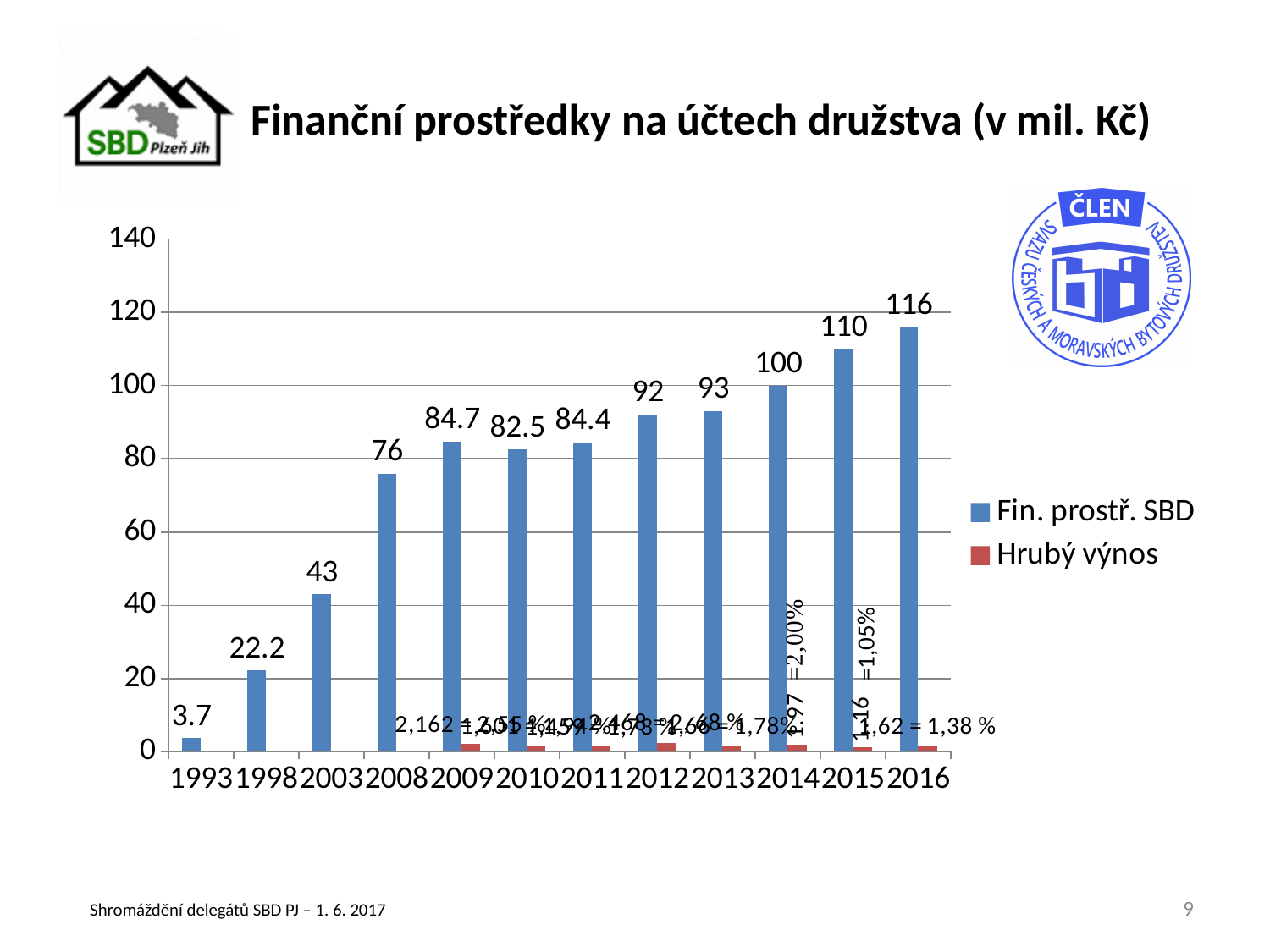
Do the Fin. prostř. SBD values generally rise or fall from 1993 to 2016? rise Is the Fin. prostř. SBD value for 2008 greater or less than 80? less What is the value of Fin. prostř. SBD for 2010? 82.5 What is the value of Fin. prostř. SBD for 1993? 3.7 What kind of chart is shown on the slide? bar chart Which year has the highest value of Fin. prostř. SBD? 2016 Which year has the larger Fin. prostř. SBD value, 2010 or 2011? 2011 How many series does the legend list? 2 What is the value of Fin. prostř. SBD for 2016? 116 Which year has the lowest value of Fin. prostř. SBD? 1993 What is the difference between the Fin. prostř. SBD values for 2016 and 2015? 6 How many years are shown on the x axis? 12